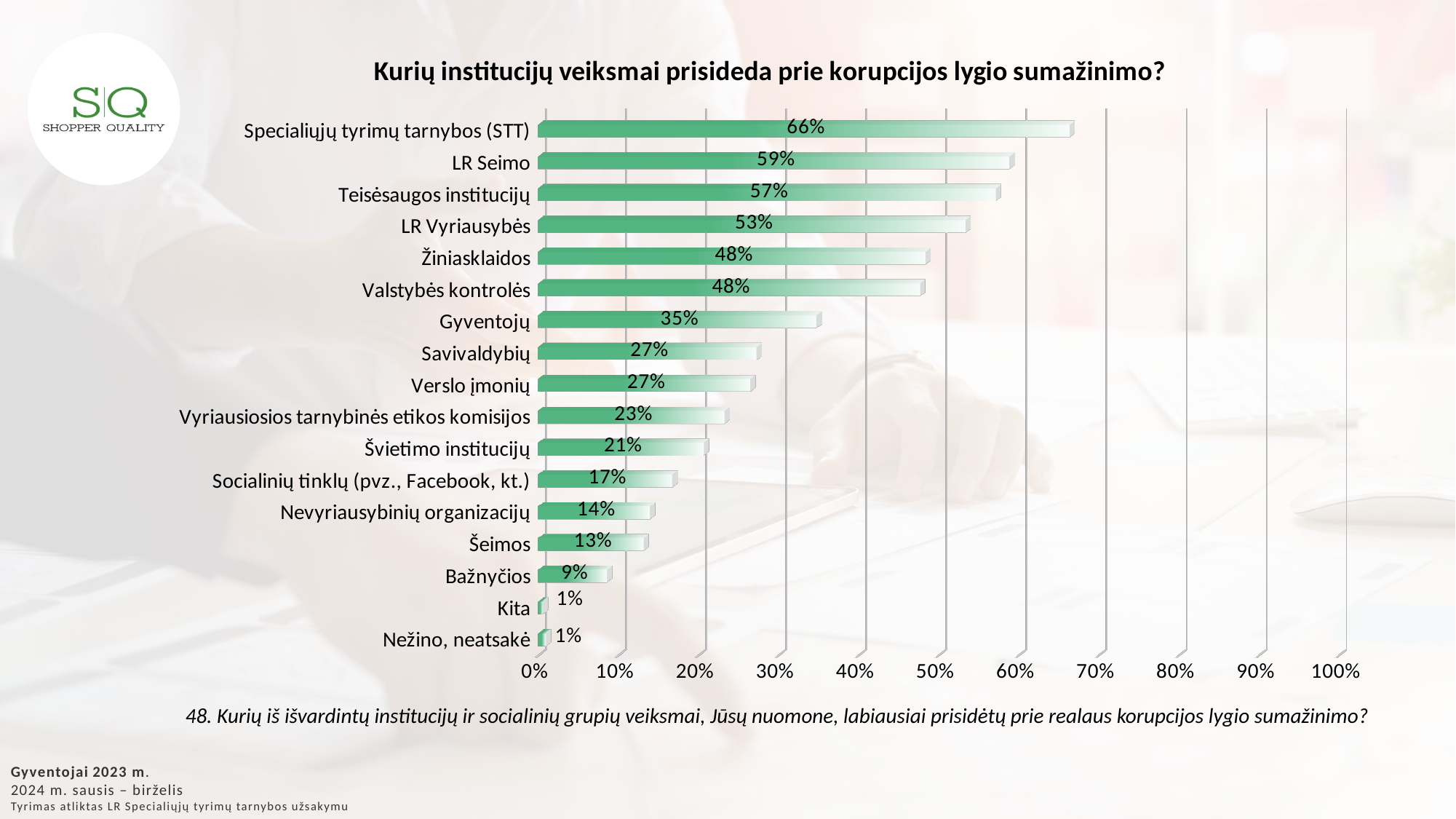
What is the value for Bažnyčios? 9% Which category has the highest value? Specialiųjų tyrimų tarnybos (STT) What is the difference between the values for LR Seimo and LR Vyriausybės? 6% What kind of chart is shown on the slide? bar chart How many categories are shown in the chart? 17 What is the value for Šeimos? 13% What is the value for Specialiųjų tyrimų tarnybos (STT)? 66% What is the title of the chart? Kurių institucijų veiksmai prisideda prie korupcijos lygio sumažinimo? Which is larger, the value for Žiniasklaidos or the value for Savivaldybių? Žiniasklaidos What is the value for Gyventojų? 35% What is the difference between the values for Specialiųjų tyrimų tarnybos (STT) and Bažnyčios? 57% Is the value for Teisėsaugos institucijų greater or less than 50%? greater